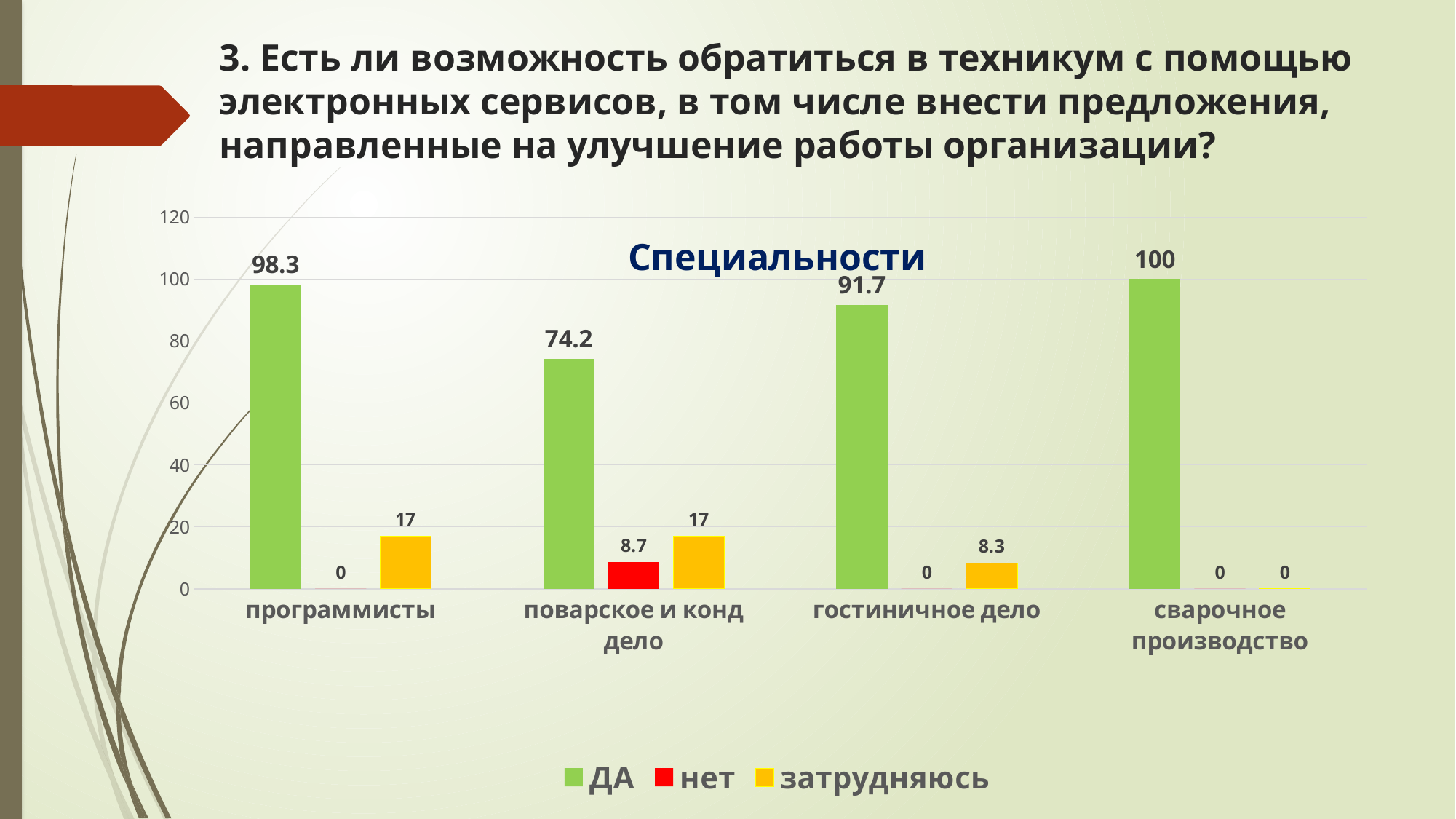
How many series does the legend list? 3 What is the title of the chart? Специальности Which is larger: the ДА value for гостиничное дело or for программисты? программисты What is the value of затрудняюсь for гостиничное дело? 8.3 What colour represents the нет series in the legend? red What is the value of нет for поварское и конд дело? 8.7 What is the value of ДА for программисты? 98.3 Which category has the highest ДА value? сварочное производство What is the difference between the ДА values for программисты and поварское и конд дело? 24.1 How many categories are shown on the x axis? 4 Which category has the lowest ДА value? поварское и конд дело What kind of chart is shown on the slide? bar chart